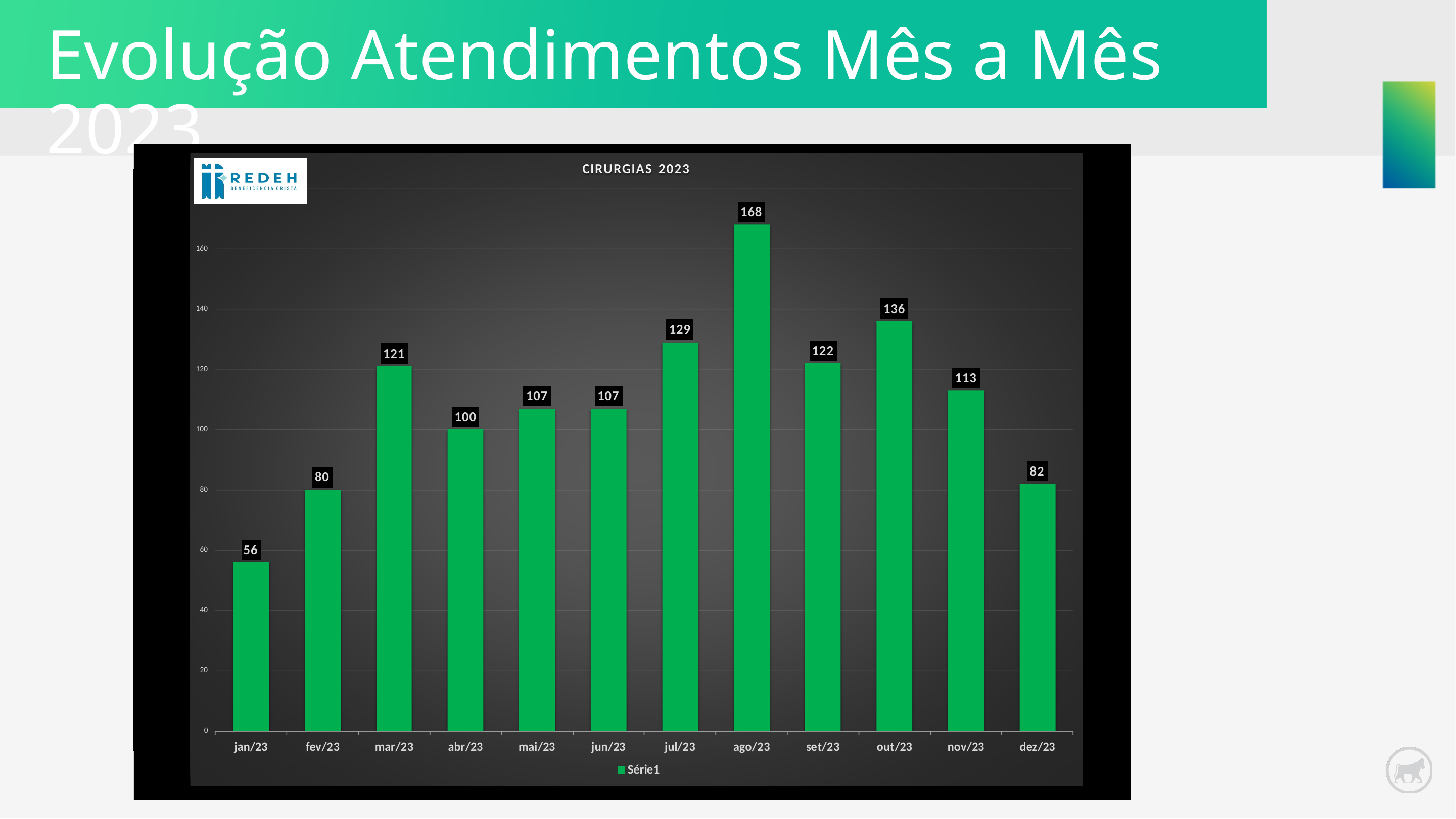
Which is larger, the value for mar/23 or the value for set/23? set/23 How many months are shown on the x axis? 12 What is the value for jan/23? 56 What is the value for ago/23? 168 What is the value for out/23? 136 What kind of chart is shown? bar chart What is the difference between the values for ago/23 and jul/23? 39 How many series does the legend list? 1 Which month has the lowest value? jan/23 What is the title of the chart? CIRURGIAS 2023 Is the value for nov/23 greater or less than 100? greater Which month has the highest value? ago/23